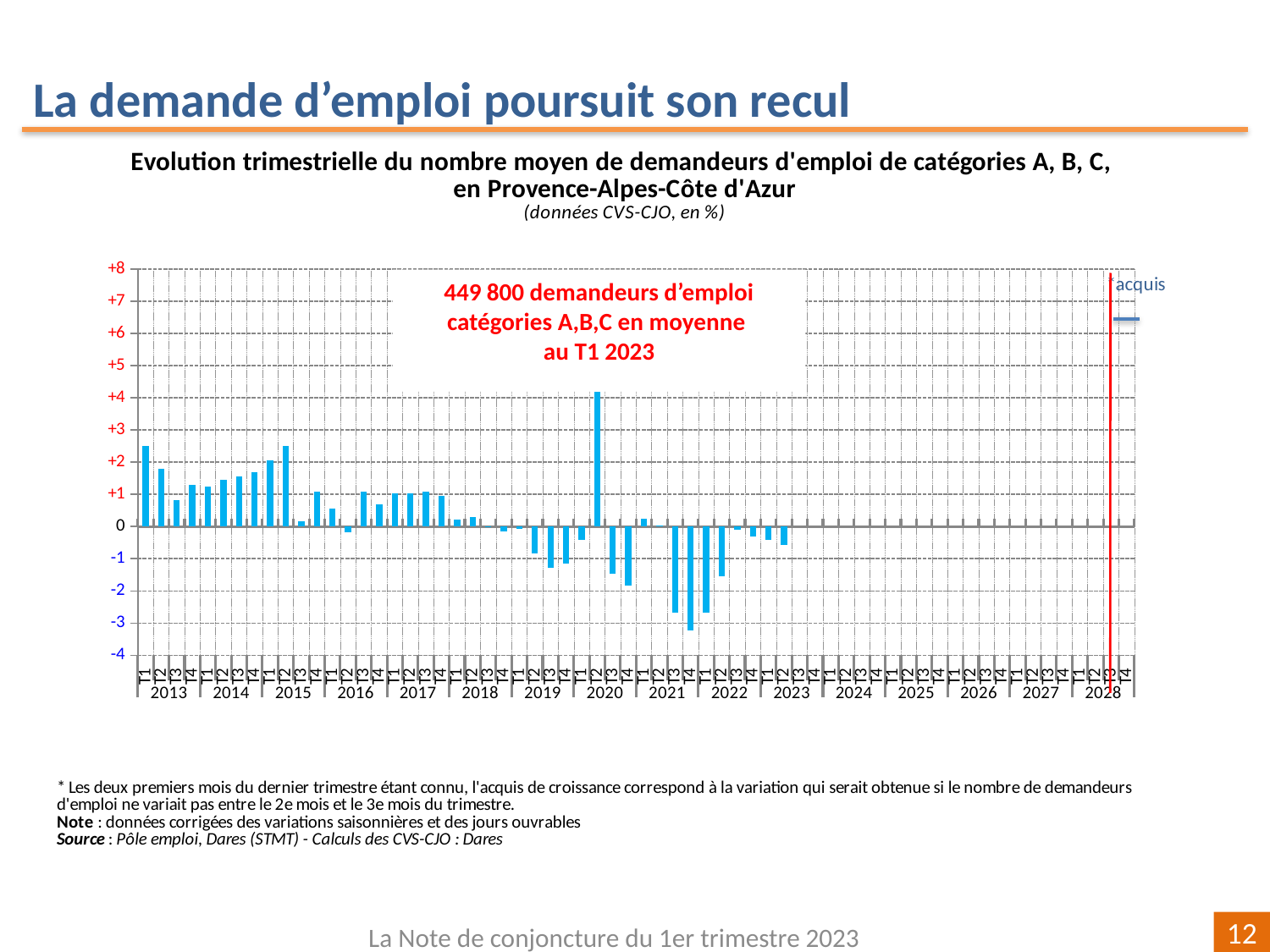
Is the value for T3 2021 greater or less than -2? less Is the value for T1 2013 greater or less than +2? greater Is the value for T1 2023 greater or less than 0? less Which quarter shows the lowest value in the chart? T4 2021 What is the highest value shown on the vertical axis of the chart? +8 What kind of chart is shown on the slide? Bar chart Which quarter shows the highest value in the chart? T2 2020 According to the annotation on the chart, how many demandeurs d'emploi of categories A, B, C were there on average in T1 2023? 449 800 Which is larger, the value for T3 2019 or the value for T3 2021? T3 2019 Do the values generally rise or fall from T1 2021 to T3 2021? fall Which is larger, the value for T2 2020 or the value for T1 2013? T2 2020